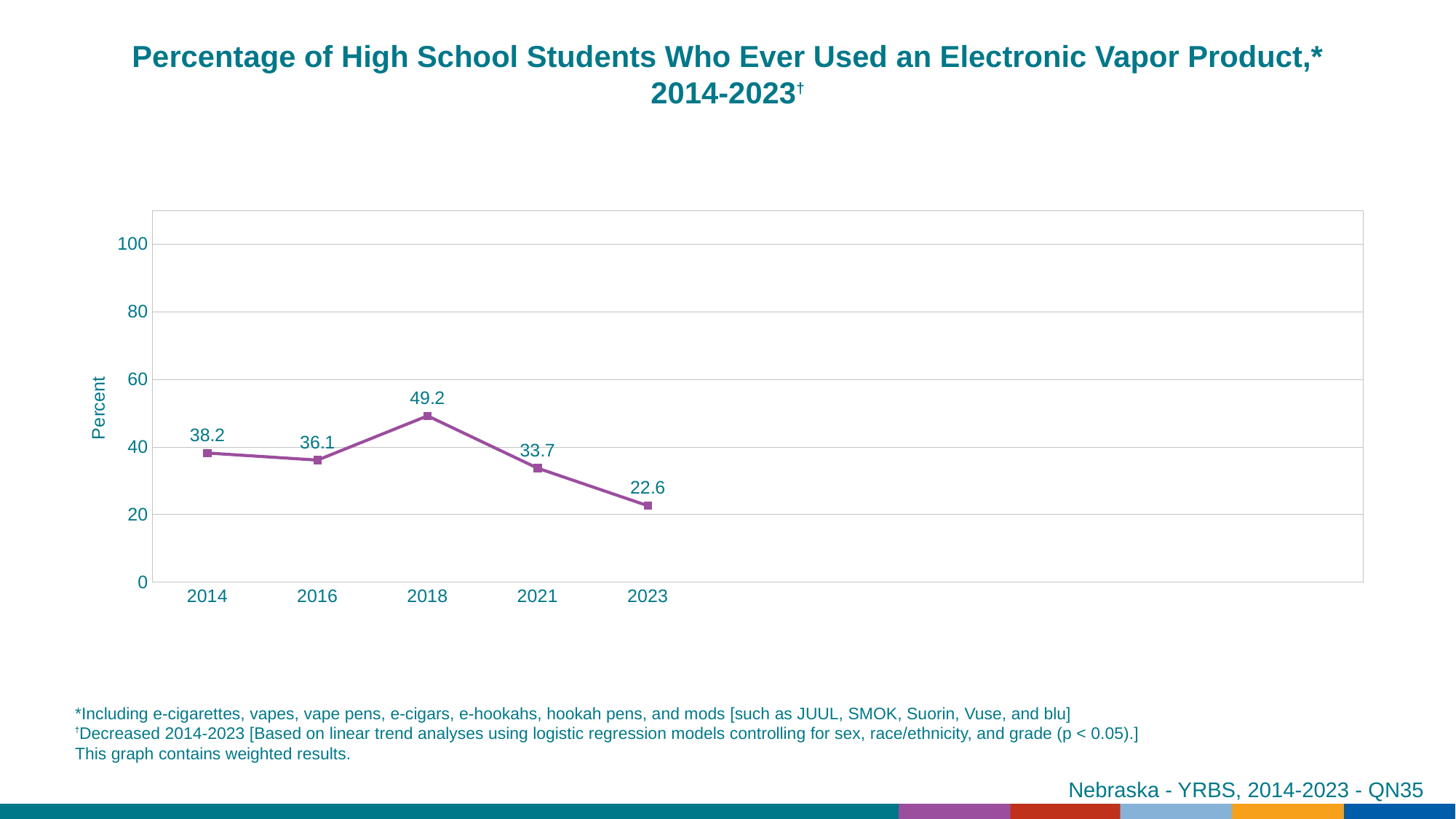
What kind of chart is shown on the slide? line chart Does the percentage rise or fall from 2018 to 2023? fall What is the difference between the 2018 value and the 2023 value? 26.6 Which year has a larger value, 2016 or 2021? 2016 What is the value plotted for 2023? 22.6 Is the value for 2018 greater or less than 40? greater What is the value plotted for 2014? 38.2 Which year has the lowest percentage? 2023 What percentage of high school students had ever used an electronic vapor product in 2018? 49.2 Which year has the highest percentage? 2018 What is the difference between the 2014 value and the 2016 value? 2.1 How many years are plotted on the chart? 5